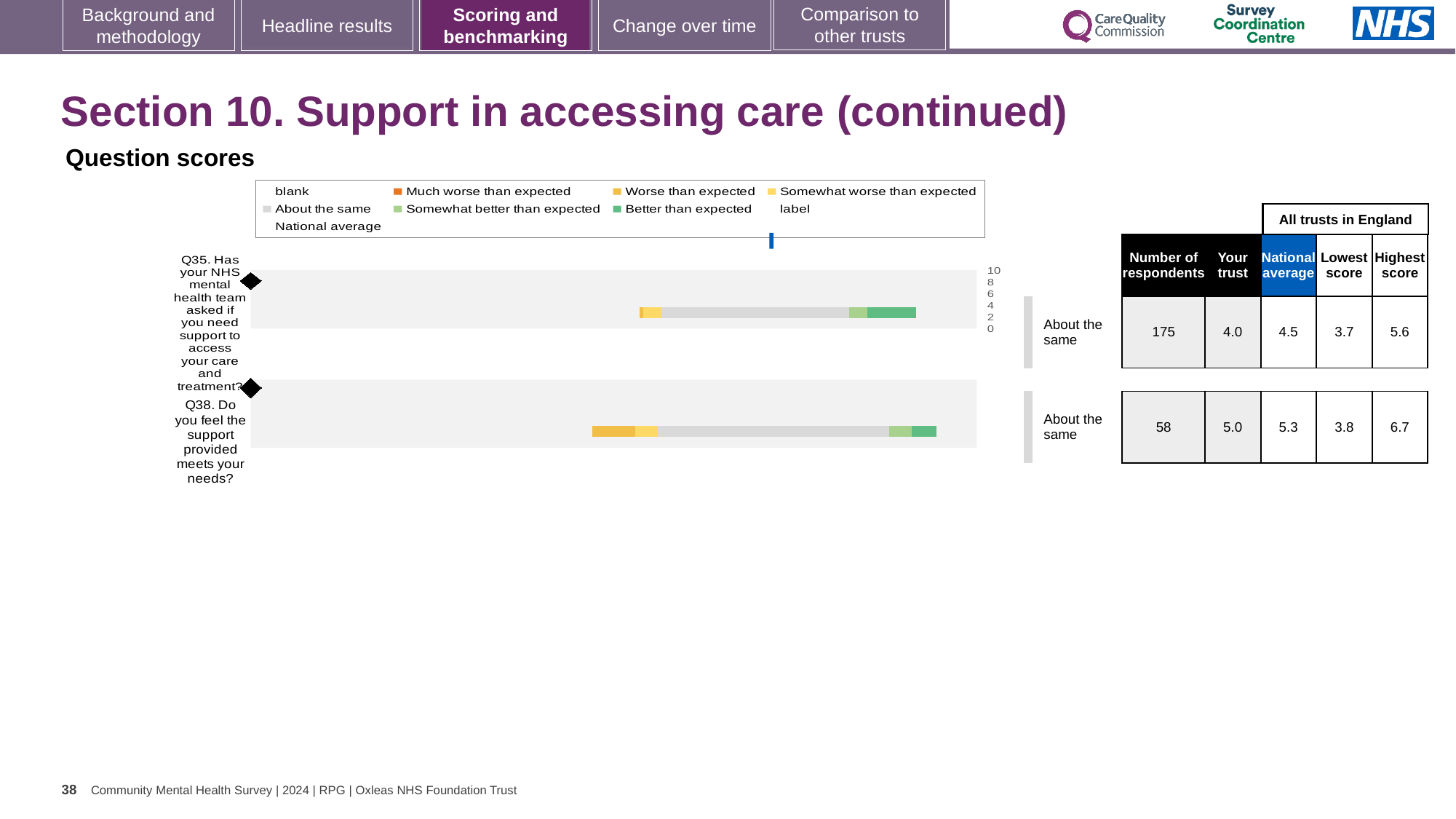
What is the difference between the highest and lowest scores across all trusts in England for Q38? 2.9 How is the trust's result for Q38 categorised relative to expectations? About the same How many respondents answered Q35? 175 Which question has the higher 'Your trust' score, Q35 or Q38? Q38 What is the difference between the national average and the 'Your trust' score for Q35? 0.5 Which question has the larger number of respondents, Q35 or Q38? Q35 What is the 'Your trust' score for Q35 (Has your NHS mental health team asked if you need support to access your care and treatment)? 4.0 What is the lowest score among all trusts in England for Q35? 3.7 What is the highest score among all trusts in England for Q38? 6.7 What kind of chart is used to show the question scores on this slide? bar chart What is the national average score for Q38 (Do you feel the support provided meets your needs)? 5.3 How many questions are plotted in the question scores chart? 2